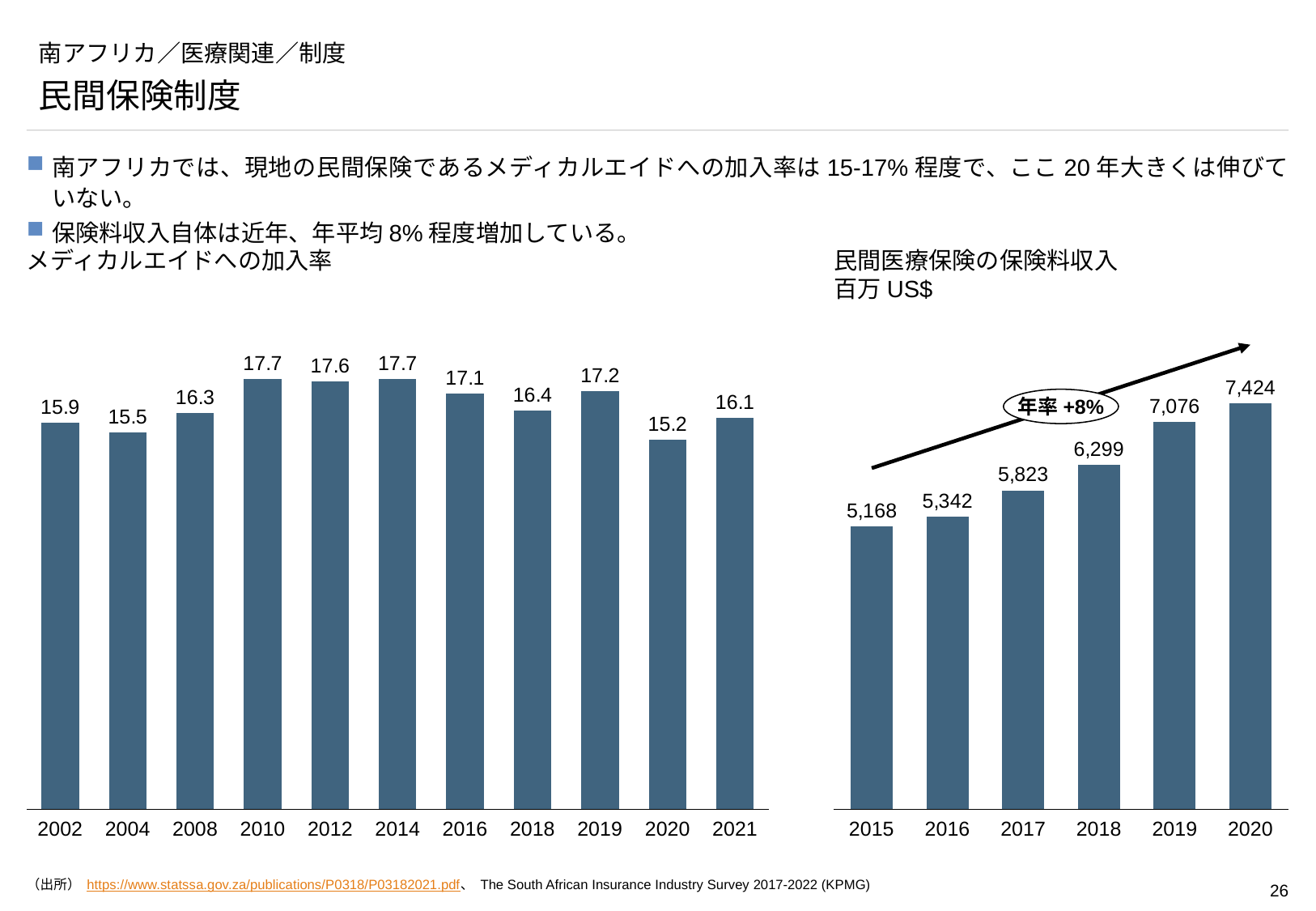
In the right chart (民間医療保険の保険料収入), what is the value for 2017? 5,823 In the left chart (メディカルエイドへの加入率), what is the value for 2020? 15.2 In the left chart (メディカルエイドへの加入率), which year has the lowest value? 2020 In the left chart (メディカルエイドへの加入率), which is larger, the value for 2002 or the value for 2004? 2002 In the right chart (民間医療保険の保険料収入), which year has the highest value? 2020 In the left chart (メディカルエイドへの加入率), what is the value for 2010? 17.7 In the left chart (メディカルエイドへの加入率), how many years are shown on the x axis? 11 In the right chart (民間医療保険の保険料収入), what is the difference between the values for 2020 and 2015? 2,256 In the right chart (民間医療保険の保険料収入), do the values rise or fall from 2015 to 2020? rise In the left chart (メディカルエイドへの加入率), what is the difference between the values for 2021 and 2020? 0.9 In the right chart (民間医療保険の保険料収入), which year has the lowest value? 2015 What type of chart is the right chart (民間医療保険の保険料収入)? bar chart